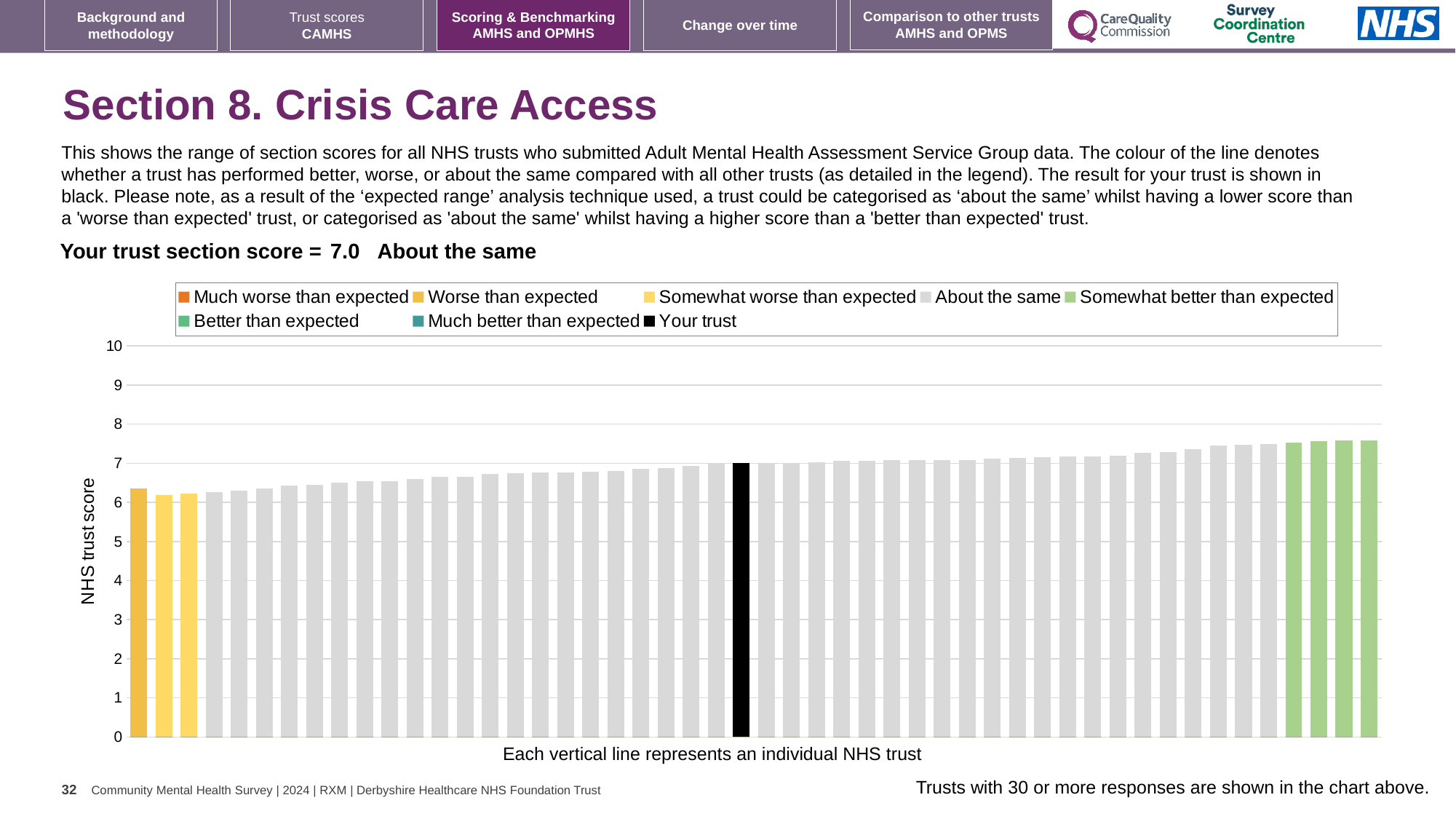
What kind of chart is shown on the slide? bar chart What is the label on the y axis of the chart? NHS trust score Which performance category is your trust placed in for Crisis Care Access? About the same Is the value of the shortest bar in the chart greater or less than 6? greater Is the value of the tallest bar in the chart greater or less than 8? less How many entries does the chart legend list? 8 Do the bar values rise or fall from left to right along the x axis? rise Is the value of the black 'Your trust' bar greater or less than 5? greater What colour is the bar representing your trust in the chart? black How many bars are coloured as 'Worse than expected' (yellow) in the chart? 1 What is the section score for your trust shown on the slide? 7.0 How many bars are coloured as 'Somewhat better than expected' (green) in the chart? 4